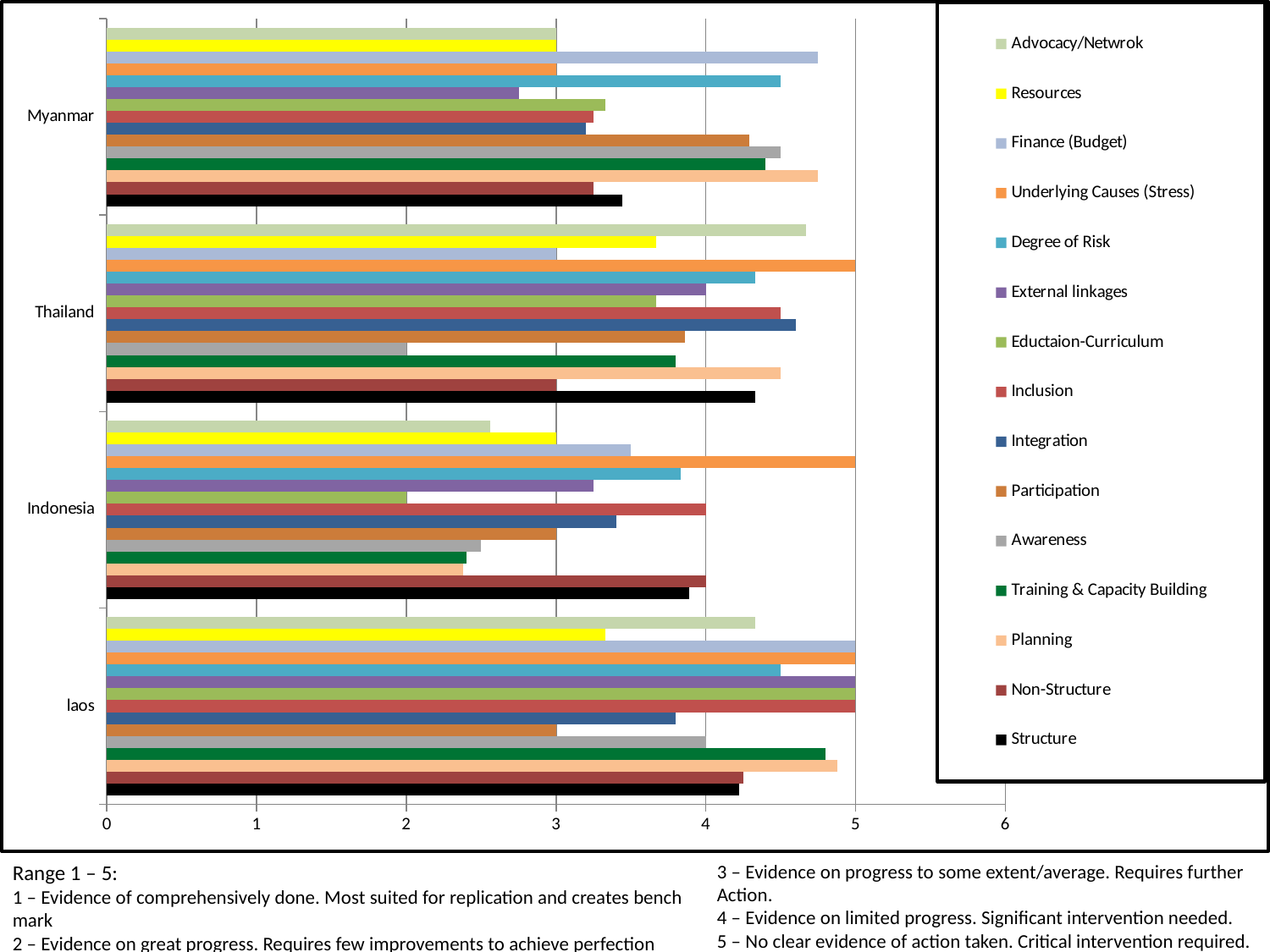
Which series has the highest value for Indonesia? Underlying Causes (Stress) What is the value for Underlying Causes (Stress) for Indonesia? 5 How many series does the chart's legend list? 15 What is the difference between the Underlying Causes (Stress) value and the Resources value for Indonesia? 2 What is the value for Eductaion-Curriculum for Indonesia? 2 What is the value for Awareness for Thailand? 2 Is the value for Finance (Budget) for Myanmar greater or less than 4? greater For Indonesia, which is larger: Underlying Causes (Stress) or Resources? Underlying Causes (Stress) Is the value for Training & Capacity Building for Indonesia greater or less than 3? less How many countries are shown on the vertical axis of the chart? 4 Which series has the lowest value for Thailand? Awareness What kind of chart is shown on the slide? bar chart